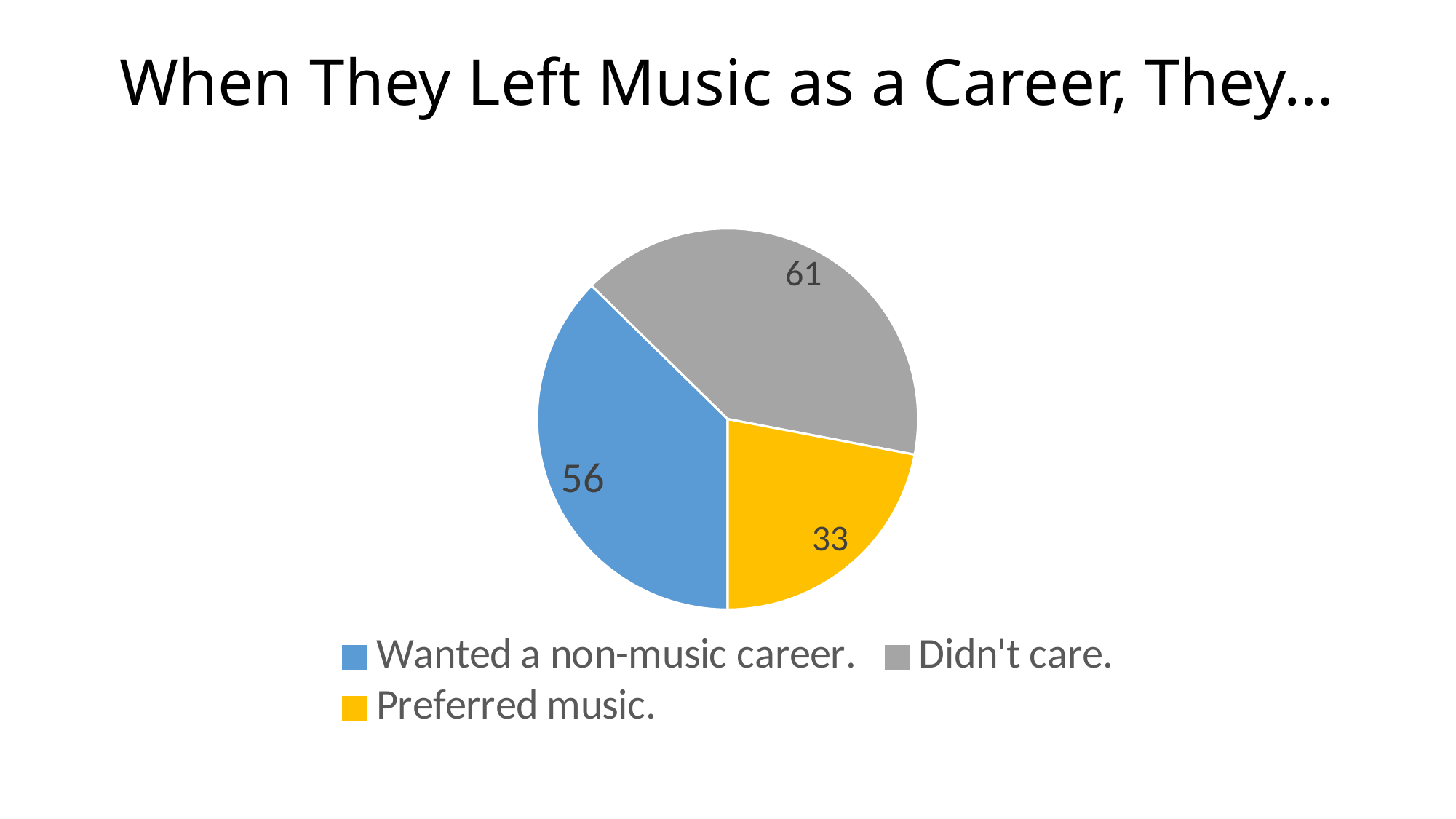
What is the difference between the values for "Didn't care." and "Preferred music."? 28 What is the value for "Preferred music."? 33 What kind of chart is shown on the slide? pie chart What colour is the slice for "Preferred music."? yellow What is the difference between the values for "Didn't care." and "Wanted a non-music career."? 5 Which category has the smallest slice? Preferred music. Which is larger, the value for "Wanted a non-music career." or the value for "Preferred music."? Wanted a non-music career. How many slices does the pie chart have? 3 What share of the pie does "Preferred music." represent? 22% What is the value for "Wanted a non-music career."? 56 Which category has the largest slice? Didn't care. What is the value for "Didn't care."? 61